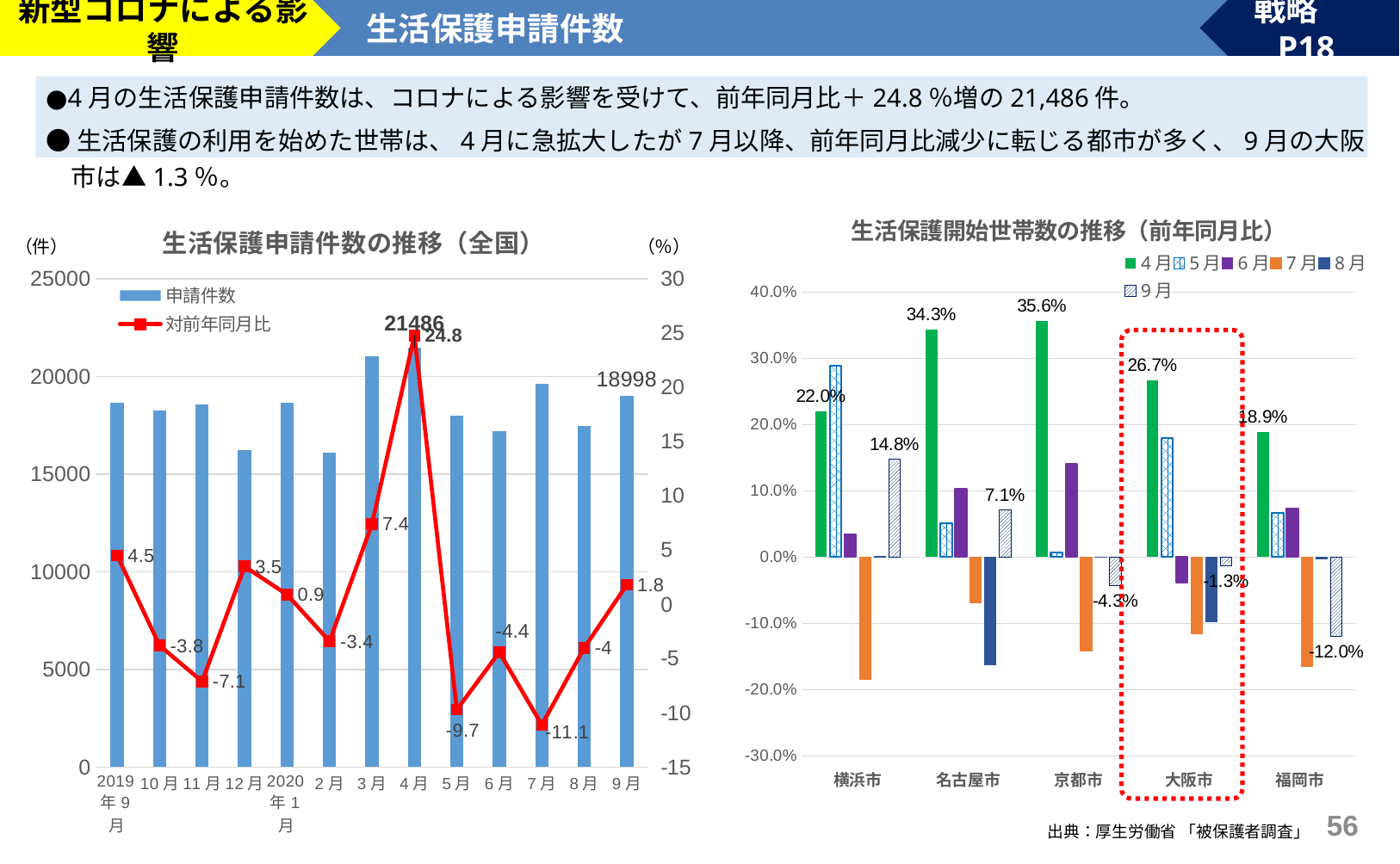
In the left chart 生活保護申請件数の推移（全国）, is the 申請件数 for 2020年3月 greater or less than 20000? greater In the left chart 生活保護申請件数の推移（全国）, which month has the highest 対前年同月比? 2020年4月 In the right chart 生活保護開始世帯数の推移（前年同月比）, which city has the larger 4月 value, 横浜市 or 大阪市? 大阪市 In the left chart 生活保護申請件数の推移（全国）, how many months are shown on the x axis? 13 In the right chart 生活保護開始世帯数の推移（前年同月比）, how many series does the legend list? 6 In the right chart 生活保護開始世帯数の推移（前年同月比）, what is the 9月 value for 福岡市? -12.0% In the right chart 生活保護開始世帯数の推移（前年同月比）, how many cities are shown on the x axis? 5 In the left chart 生活保護申請件数の推移（全国）, what is the difference between the 申請件数 for 2020年4月 and 2020年9月? 2488 In the left chart 生活保護申請件数の推移（全国）, what is the 申請件数 value for 2020年4月? 21486 In the left chart 生活保護申請件数の推移（全国）, what is the 対前年同月比 value for 2020年7月? -11.1 In the right chart 生活保護開始世帯数の推移（前年同月比）, what is the 4月 value for 京都市? 35.6% In the left chart 生活保護申請件数の推移（全国）, which month has the lowest 対前年同月比? 2020年7月